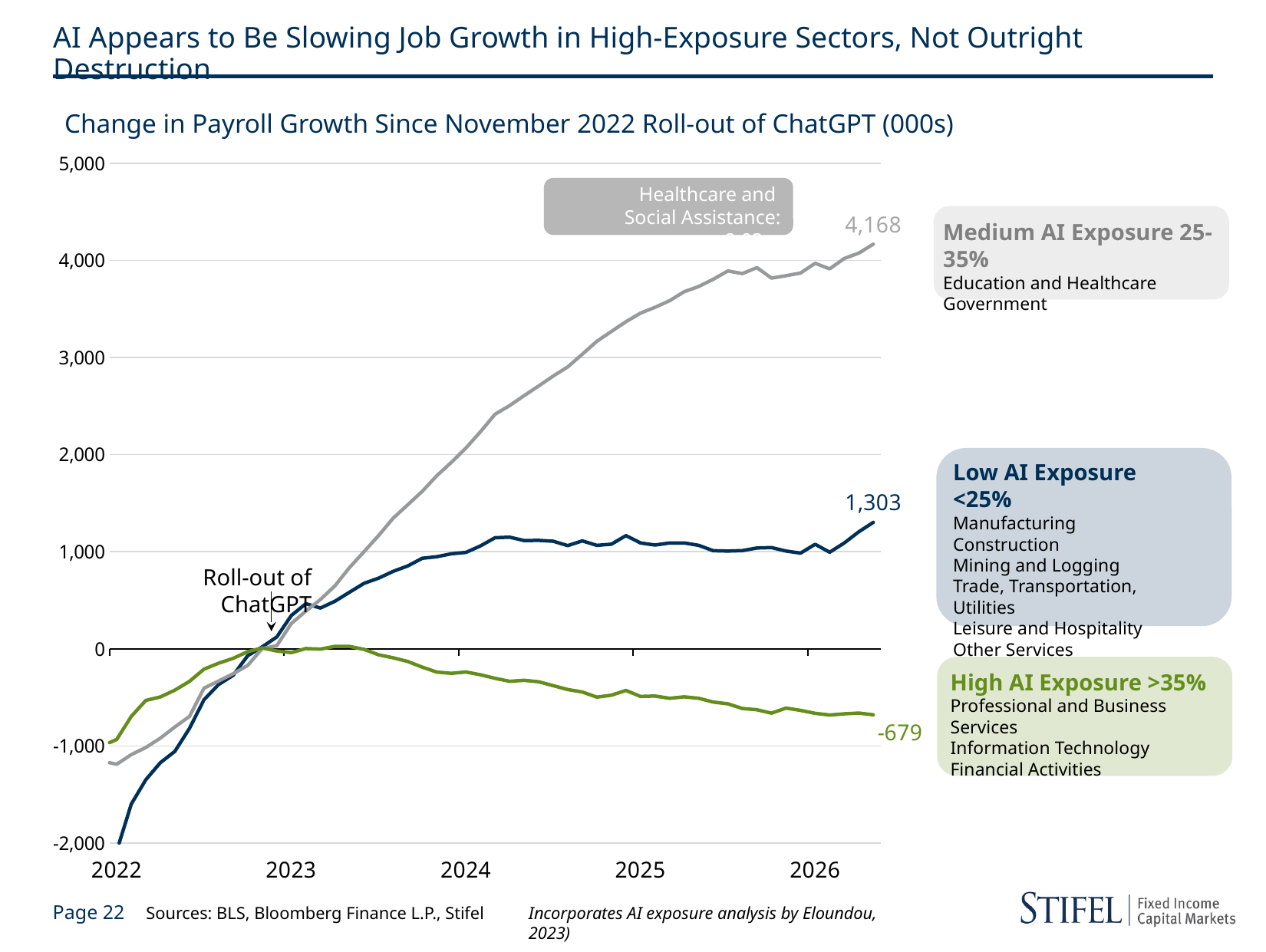
What is the title of the chart? Change in Payroll Growth Since November 2022 Roll-out of ChatGPT (000s) What kind of chart is shown on the slide? line chart What is the final labelled value of the Medium AI Exposure (gray) line? 4,168 Is the final value of the Medium AI Exposure line greater or less than 4,000? greater Which ends higher, the Low AI Exposure line or the High AI Exposure line? Low AI Exposure Does the High AI Exposure (green) line rise or fall from 2023 to 2026? fall What is the final labelled value of the Low AI Exposure (dark blue) line? 1,303 How many exposure-group lines are plotted on the chart? 3 Which exposure group's line ends at the lowest value? High AI Exposure >35% What is the difference between the final values of the Medium AI Exposure line (4,168) and the Low AI Exposure line (1,303)? 2,865 What is the final labelled value of the High AI Exposure (green) line? -679 Which exposure group's line ends at the highest value? Medium AI Exposure 25-35%